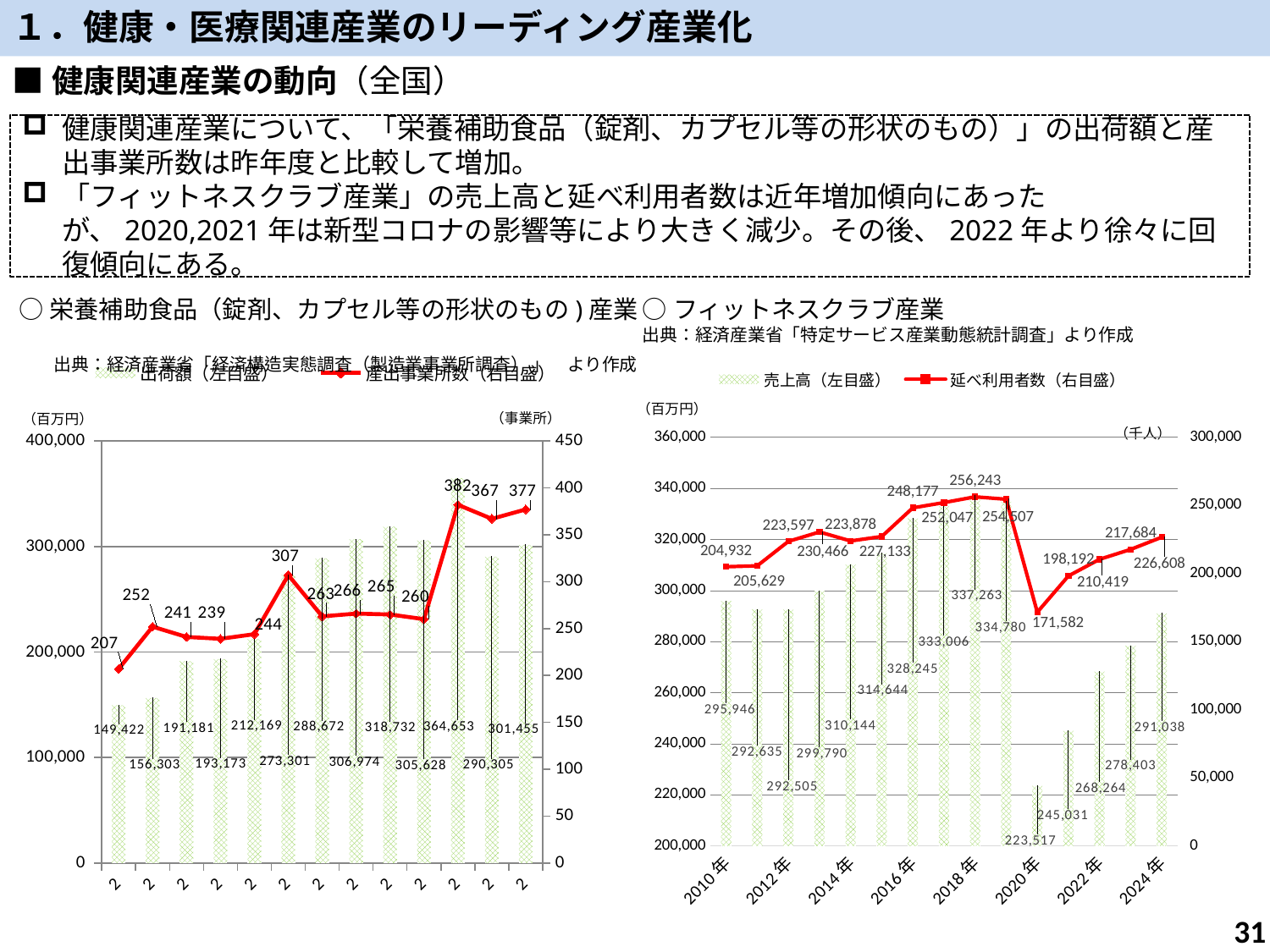
In the フィットネスクラブ産業 chart on the right, which year has the lowest 売上高? 2020年 In the 栄養補助食品 chart on the left, what is the difference between the highest and lowest 産出事業所数 values? 175 What kind of chart is the フィットネスクラブ産業 chart on the right? A combined bar and line chart How many series does the legend of the フィットネスクラブ産業 chart on the right list? 2 In the フィットネスクラブ産業 chart on the right, what is the highest 延べ利用者数 value shown? 256,243 In the フィットネスクラブ産業 chart on the right, what is the 売上高 value for 2020年? 223,517 In the フィットネスクラブ産業 chart on the right, how many bars are plotted? 15 In the フィットネスクラブ産業 chart on the right, is the 延べ利用者数 larger in 2022年 or 2024年? 2024年 In the 栄養補助食品 chart on the left, what is the highest 産出事業所数 value shown? 382 In the フィットネスクラブ産業 chart on the right, what is the 延べ利用者数 value for 2018年? 256,243 In the フィットネスクラブ産業 chart on the right, what is the difference between the 売上高 for 2018年 and 2020年? 113,746 In the 栄養補助食品 chart on the left, what is the lowest 出荷額 value shown? 149,422